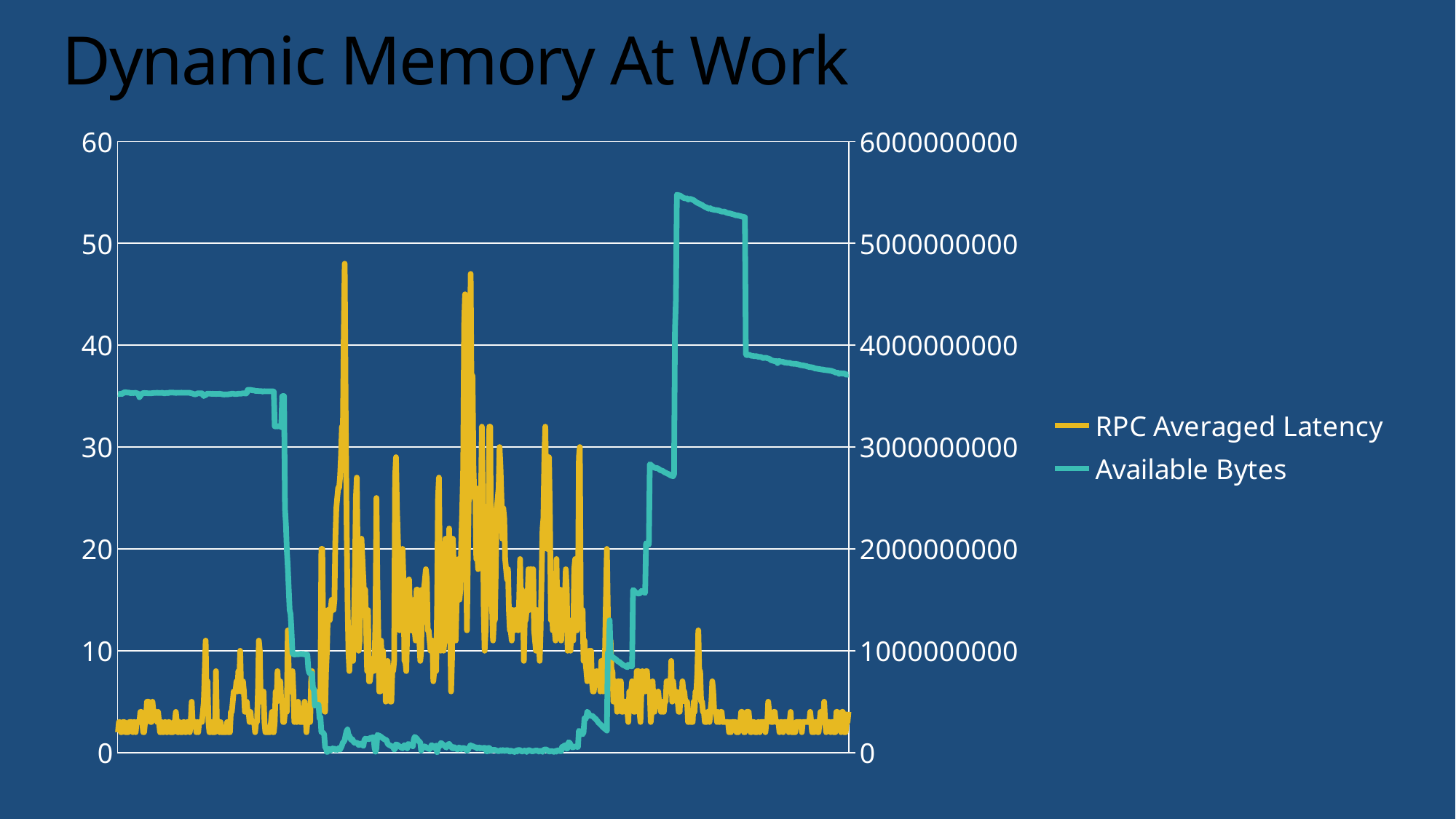
Is the highest peak of the RPC Averaged Latency line greater or less than 50 on the left axis? less Is the Available Bytes value at the start of the chart greater or less than 3000000000? greater Is the highest value of the Available Bytes line greater or less than 5000000000 on the right axis? greater What is the maximum value shown on the right vertical axis? 6000000000 How many series does the legend list? 2 What is the maximum value shown on the left vertical axis? 60 What kind of chart is shown on the slide? line chart What is the title of the chart? Dynamic Memory At Work Which series is drawn in yellow? RPC Averaged Latency